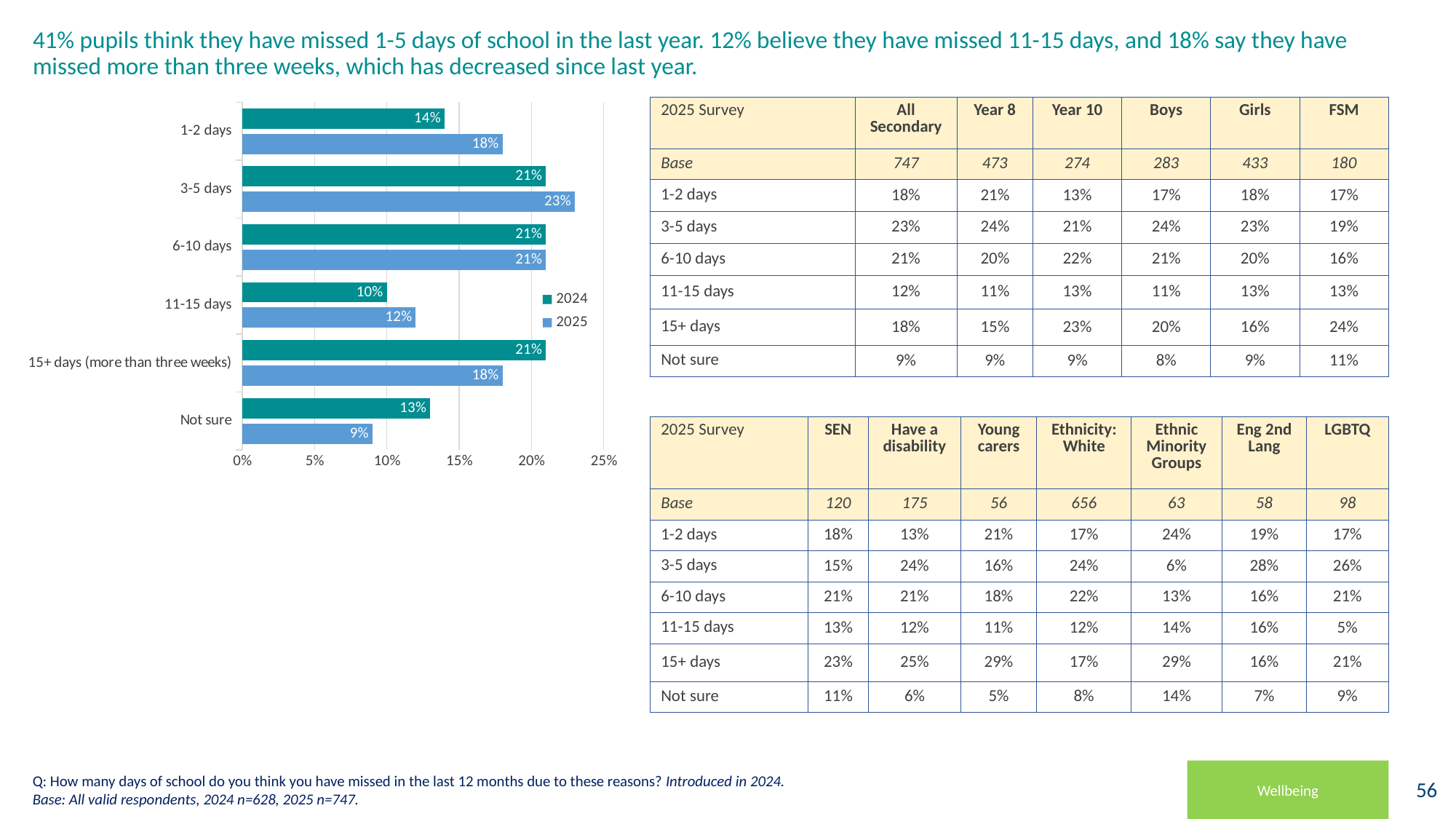
What kind of chart is shown on the slide? Bar chart What is the difference between the 2024 and 2025 values for Not sure? 4% What is the 2024 value for 1-2 days? 14% What is the 2025 value for Not sure? 9% Which category has the highest 2025 value? 3-5 days Which series is shown in the lighter blue colour? 2025 How many categories are shown on the chart? 6 What is the 2025 value for 3-5 days? 23% How many series does the legend list? 2 Which category has the lowest 2024 value? 11-15 days What is the difference between the 2024 and 2025 values for 1-2 days? 4% Which is larger for 15+ days (more than three weeks): the 2024 value or the 2025 value? 2024